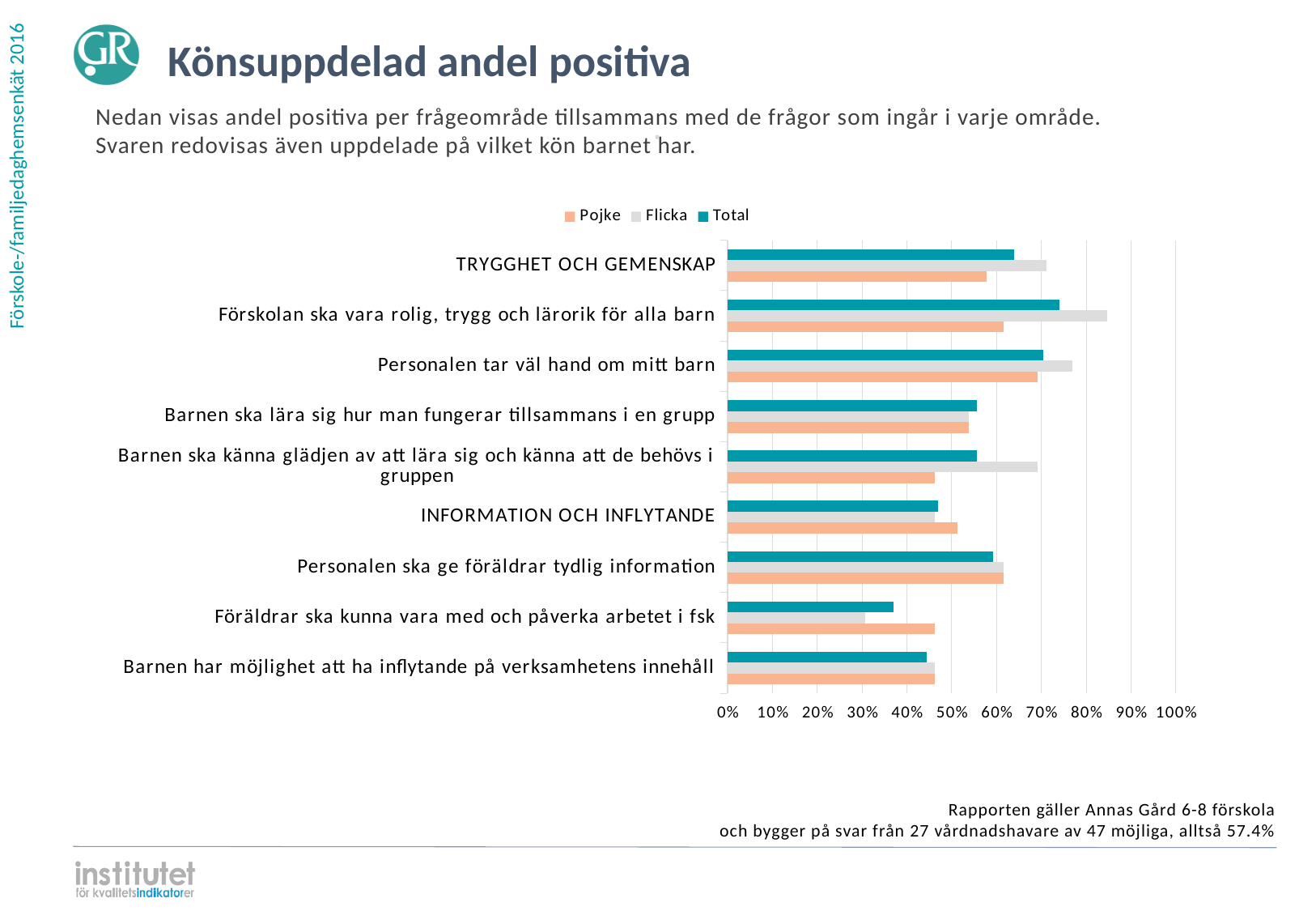
Which category has the lowest Total value? Föräldrar ska kunna vara med och påverka arbetet i fsk Is the Flicka value for 'Föräldrar ska kunna vara med och påverka arbetet i fsk' greater or less than 40%? less How many categories (question areas and questions) are plotted on the chart? 9 For 'Föräldrar ska kunna vara med och påverka arbetet i fsk', which is larger: the Pojke value or the Flicka value? Pojke How many series does the legend list? 3 Is the Flicka value for 'Personalen tar väl hand om mitt barn' greater or less than 70%? greater Is the Total value for 'Förskolan ska vara rolig, trygg och lärorik för alla barn' greater or less than 70%? greater What kind of chart is shown on the slide? Bar chart Which category has the highest Pojke value? Personalen tar väl hand om mitt barn What is the title of the chart slide? Könsuppdelad andel positiva For 'Förskolan ska vara rolig, trygg och lärorik för alla barn', which is larger: the Pojke value or the Flicka value? Flicka Which category has the highest Flicka value? Förskolan ska vara rolig, trygg och lärorik för alla barn